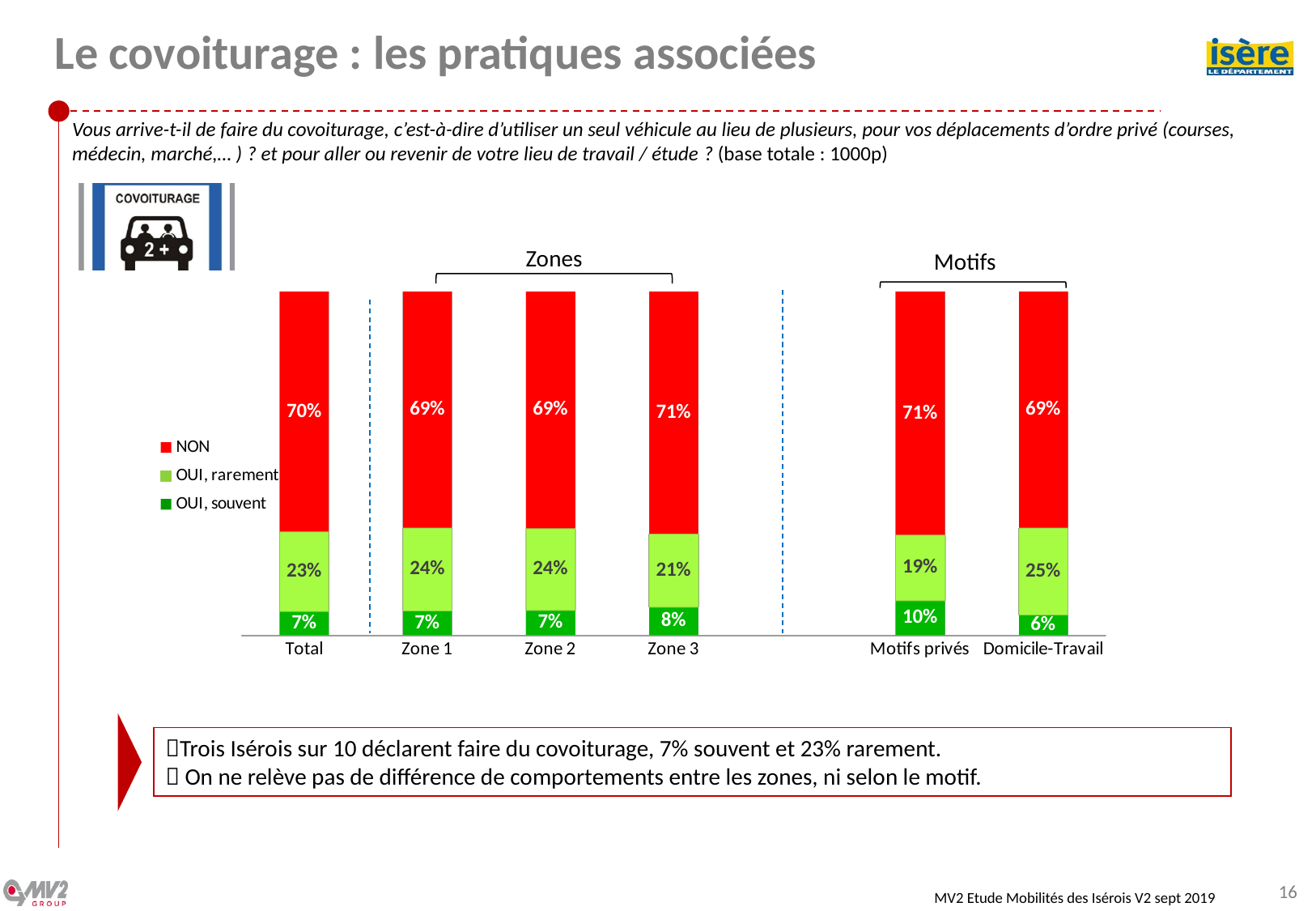
Which colour represents the NON series in the legend? Red What is the value of NON for Total? 70% What is the value of OUI, rarement for Domicile-Travail? 25% How many series does the legend list? 3 How many categories are shown on the x axis? 6 Which category has the lowest value for OUI, rarement? Motifs privés What is the value of OUI, souvent for Motifs privés? 10% Which category has the highest value for OUI, souvent? Motifs privés What kind of chart is shown on the slide? Stacked bar chart What is the value of OUI, rarement for Zone 3? 21% Which is larger, the OUI, rarement value for Zone 1 or for Zone 3? Zone 1 What is the difference between the OUI, souvent values for Motifs privés and Domicile-Travail? 4%